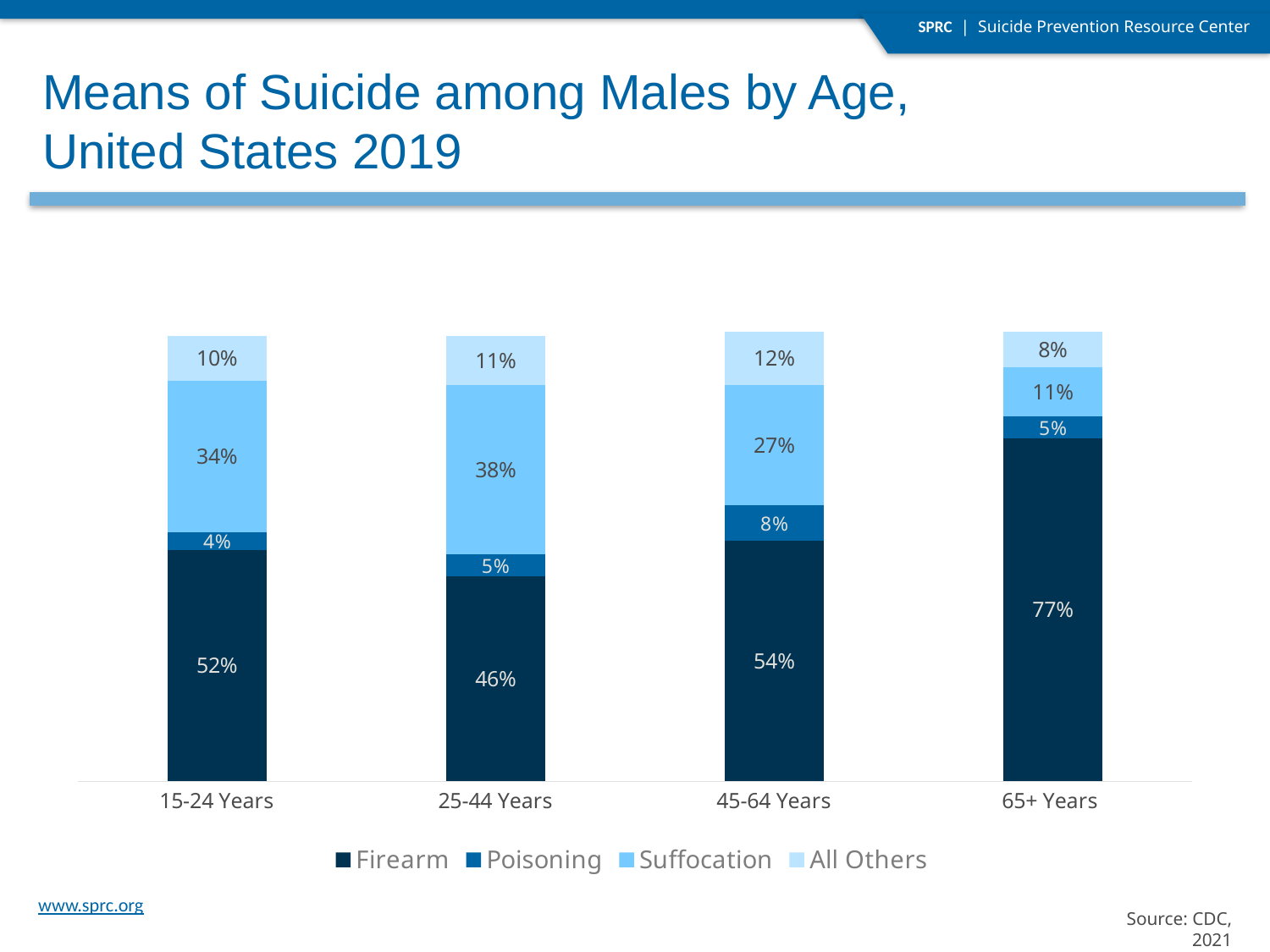
What is the difference between the Firearm share for 65+ Years and for 25-44 Years? 31% Which is larger, the Suffocation share for 15-24 Years or for 45-64 Years? 15-24 Years What is the Poisoning share for males aged 45-64 Years? 8% What is the Suffocation share for males aged 25-44 Years? 38% What kind of chart is shown on the slide? Stacked bar chart Which age group has the highest Firearm share? 65+ Years How many series does the legend list? 4 Which age group has the lowest Suffocation share? 65+ Years How many age groups are shown on the x axis? 4 What is the total of the stacked bar for 15-24 Years? 100% What is the Firearm share for males aged 65+ Years? 77% What is the All Others share for males aged 15-24 Years? 10%